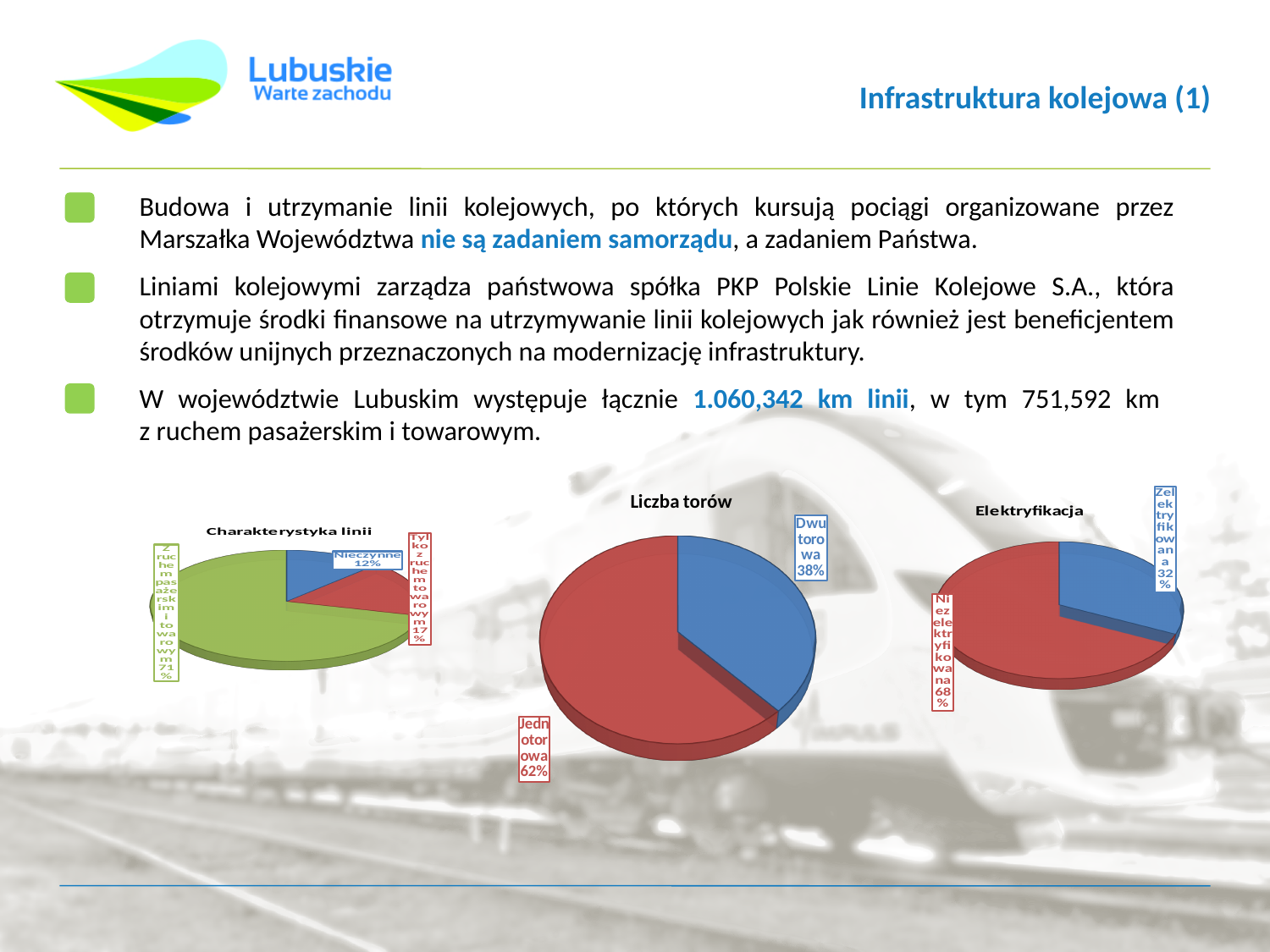
In the 'Charakterystyka linii' chart, how many slices does the pie have? 3 In the 'Charakterystyka linii' chart, what percentage is shown for 'Tylko z ruchem towarowym'? 17% What type of chart is the 'Liczba torów' chart? Pie chart In the 'Charakterystyka linii' chart, what share of lines is labelled 'Z ruchem pasażerskim i towarowym'? 71% In the 'Liczba torów' chart, what percentage is shown for 'Jednotorowa'? 62% In the 'Charakterystyka linii' chart, which category has the smallest slice? Nieczynne In the 'Charakterystyka linii' chart, what percentage is shown for 'Nieczynne'? 12% In the 'Charakterystyka linii' chart, which category has the largest slice? Z ruchem pasażerskim i towarowym In the 'Liczba torów' chart, what is the difference in percentage points between 'Jednotorowa' and 'Dwutorowa'? 24 In the 'Elektryfikacja' chart, which is larger: 'Niezelektryfikowana' or 'Zelektryfikowana'? Niezelektryfikowana In the 'Elektryfikacja' chart, what percentage is shown for 'Zelektryfikowana'? 32% In the 'Liczba torów' chart, what percentage is shown for 'Dwutorowa'? 38%